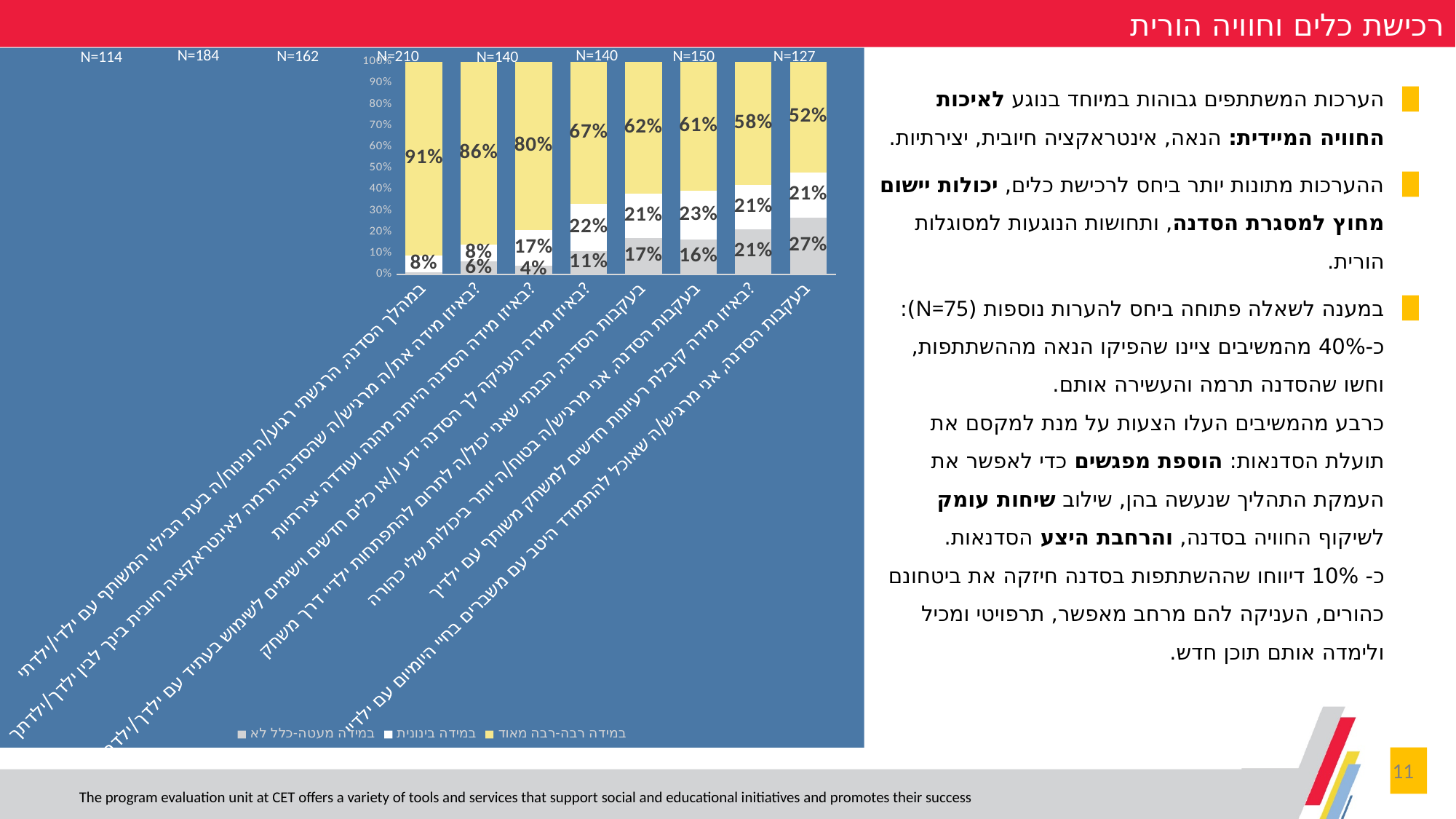
Do the 'במידה רבה-רבה מאוד' (yellow) values rise or fall moving from left to right across the bars? Fall What is the 'במידה רבה-רבה מאוד' (yellow) value for the leftmost bar? 91% Which bar has the highest 'במידה רבה-רבה מאוד' (yellow) value? The leftmost bar (91%) What is the 'במידה מעטה-כלל לא' (grey) value for the rightmost bar? 27% Which colour represents 'במידה רבה-רבה מאוד' in the legend? Yellow Which has a larger 'במידה רבה-רבה מאוד' (yellow) value: the fourth bar from the left (67%) or the fifth bar from the left (62%)? The fourth bar from the left What is the 'במידה בינונית' (white) value for the sixth bar from the left? 23% How many bars (categories) does the chart contain? 8 How many series does the chart legend list? 3 What is the difference between the highest and lowest 'במידה רבה-רבה מאוד' (yellow) values? 39 percentage points What kind of chart is shown on the slide? Stacked bar chart Which bar has the lowest 'במידה רבה-רבה מאוד' (yellow) value? The rightmost bar (52%)